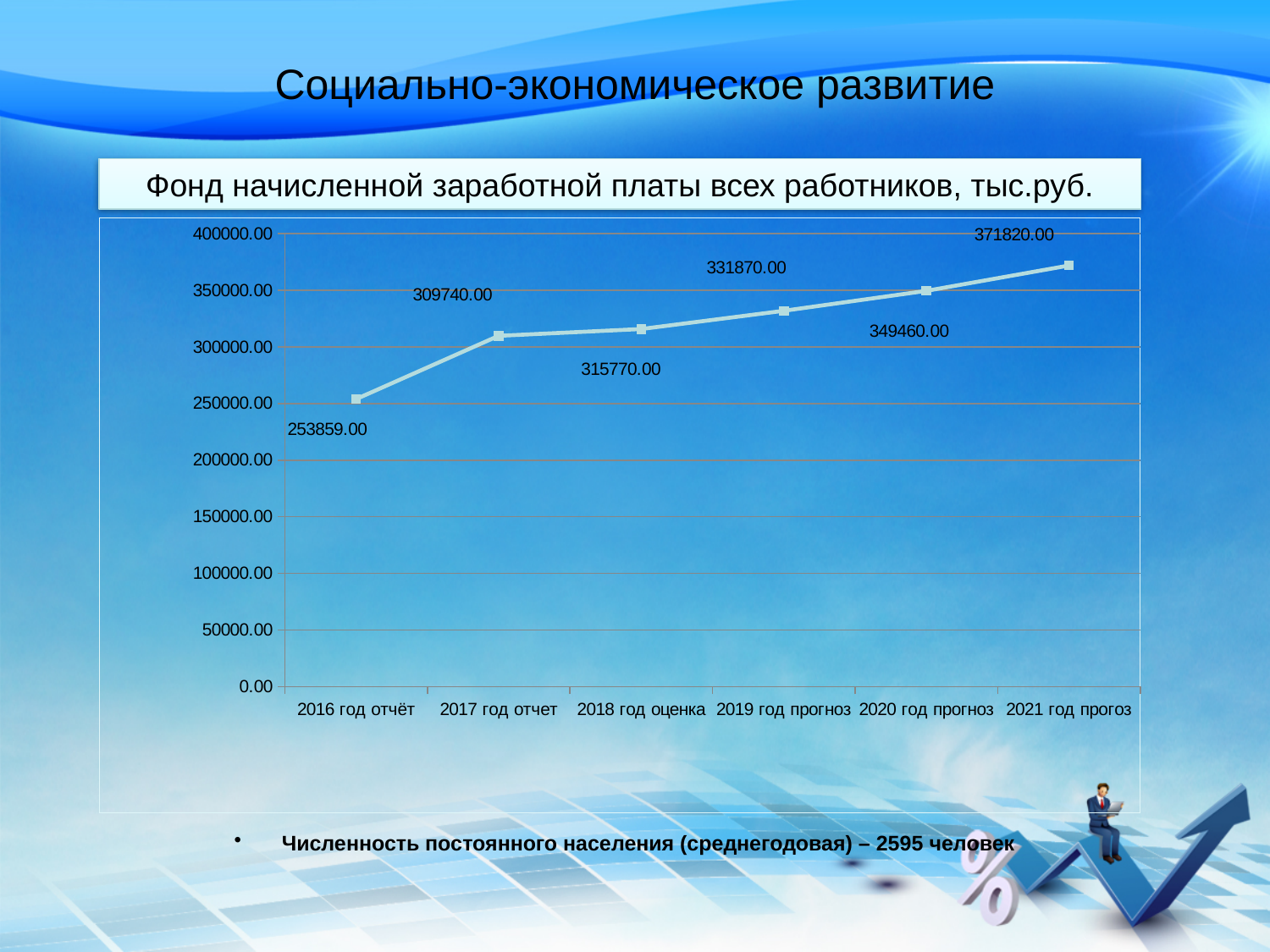
What is the value for 2021 год прогоз? 371820.00 What is the value for 2016 год отчёт? 253859.00 Which category has the lowest value? 2016 год отчёт Is the value for 2017 год отчет greater or less than 300000.00? greater What kind of chart is shown? line chart What is the value for 2019 год прогноз? 331870.00 Which category has the highest value? 2021 год прогоз What is the difference between the values for 2017 год отчет and 2016 год отчёт? 55881.00 Which is larger, the value for 2018 год оценка or the value for 2020 год прогноз? 2020 год прогноз Do the values rise or fall from 2016 год отчёт to 2021 год прогоз? rise What is the difference between the values for 2021 год прогоз and 2020 год прогноз? 22360.00 How many categories are shown on the x axis? 6